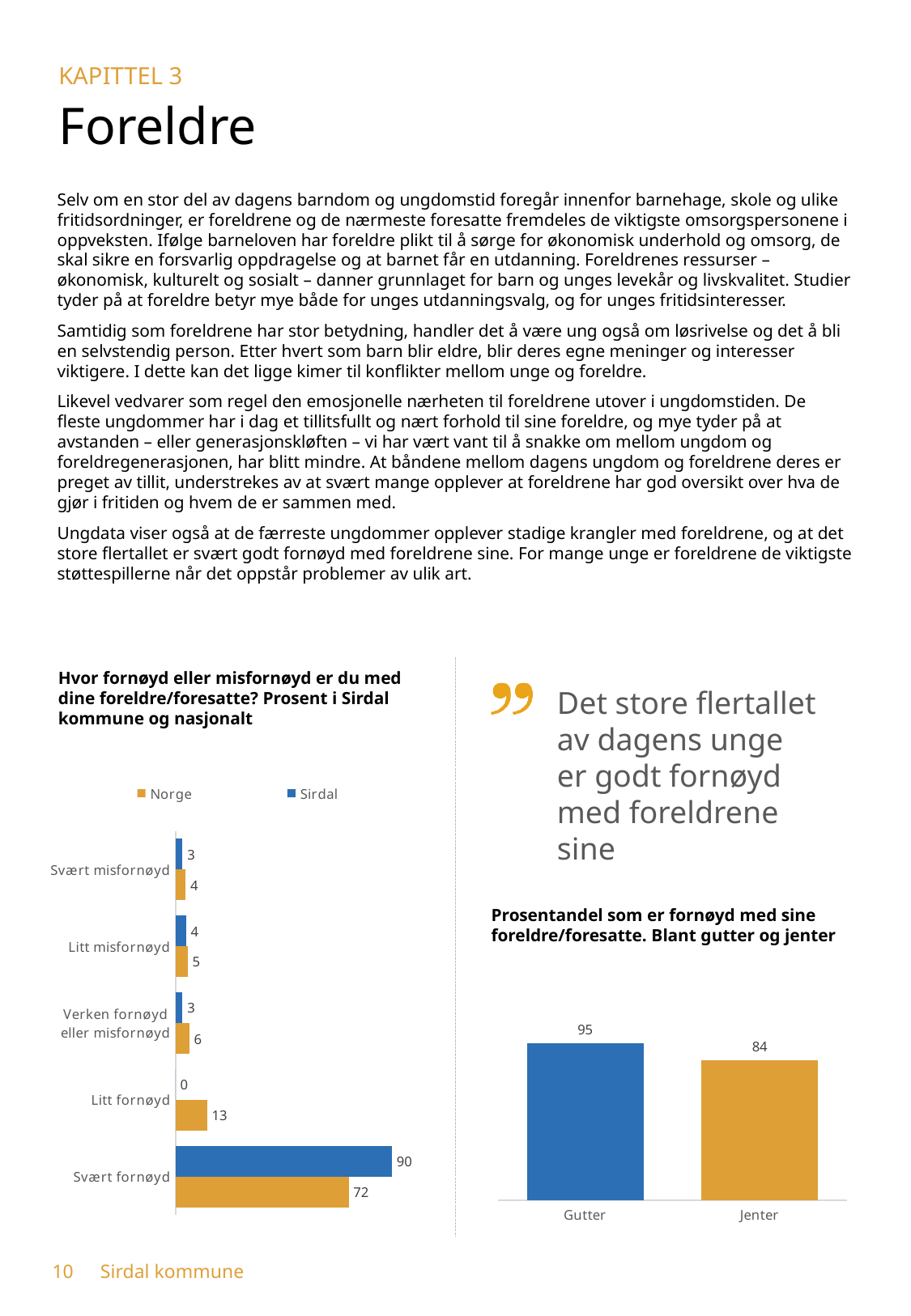
In the left chart (Hvor fornøyd eller misfornøyd er du med dine foreldre/foresatte?), which colour represents Sirdal? Blue In the left chart (Hvor fornøyd eller misfornøyd er du med dine foreldre/foresatte?), how many categories are shown? 5 In the left chart (Hvor fornøyd eller misfornøyd er du med dine foreldre/foresatte?), what is the value for Norge in the 'Litt fornøyd' category? 13 In the right chart (Prosentandel som er fornøyd med sine foreldre/foresatte), what is the value for Gutter? 95 In the left chart (Hvor fornøyd eller misfornøyd er du med dine foreldre/foresatte?), how many series does the legend list? 2 In the left chart (Hvor fornøyd eller misfornøyd er du med dine foreldre/foresatte?), what is the value for Norge in the 'Verken fornøyd eller misfornøyd' category? 6 In the left chart (Hvor fornøyd eller misfornøyd er du med dine foreldre/foresatte?), what is the difference between the Sirdal and Norge values for 'Svært fornøyd'? 18 In the right chart (Prosentandel som er fornøyd med sine foreldre/foresatte), which is larger, Gutter or Jenter? Gutter In the left chart (Hvor fornøyd eller misfornøyd er du med dine foreldre/foresatte?), which category has the lowest value for Sirdal? Litt fornøyd In the left chart (Hvor fornøyd eller misfornøyd er du med dine foreldre/foresatte?), what is the value for Sirdal in the 'Svært fornøyd' category? 90 In the right chart (Prosentandel som er fornøyd med sine foreldre/foresatte), what is the difference between Gutter and Jenter? 11 In the left chart (Hvor fornøyd eller misfornøyd er du med dine foreldre/foresatte?), which category has the highest value for Norge? Svært fornøyd